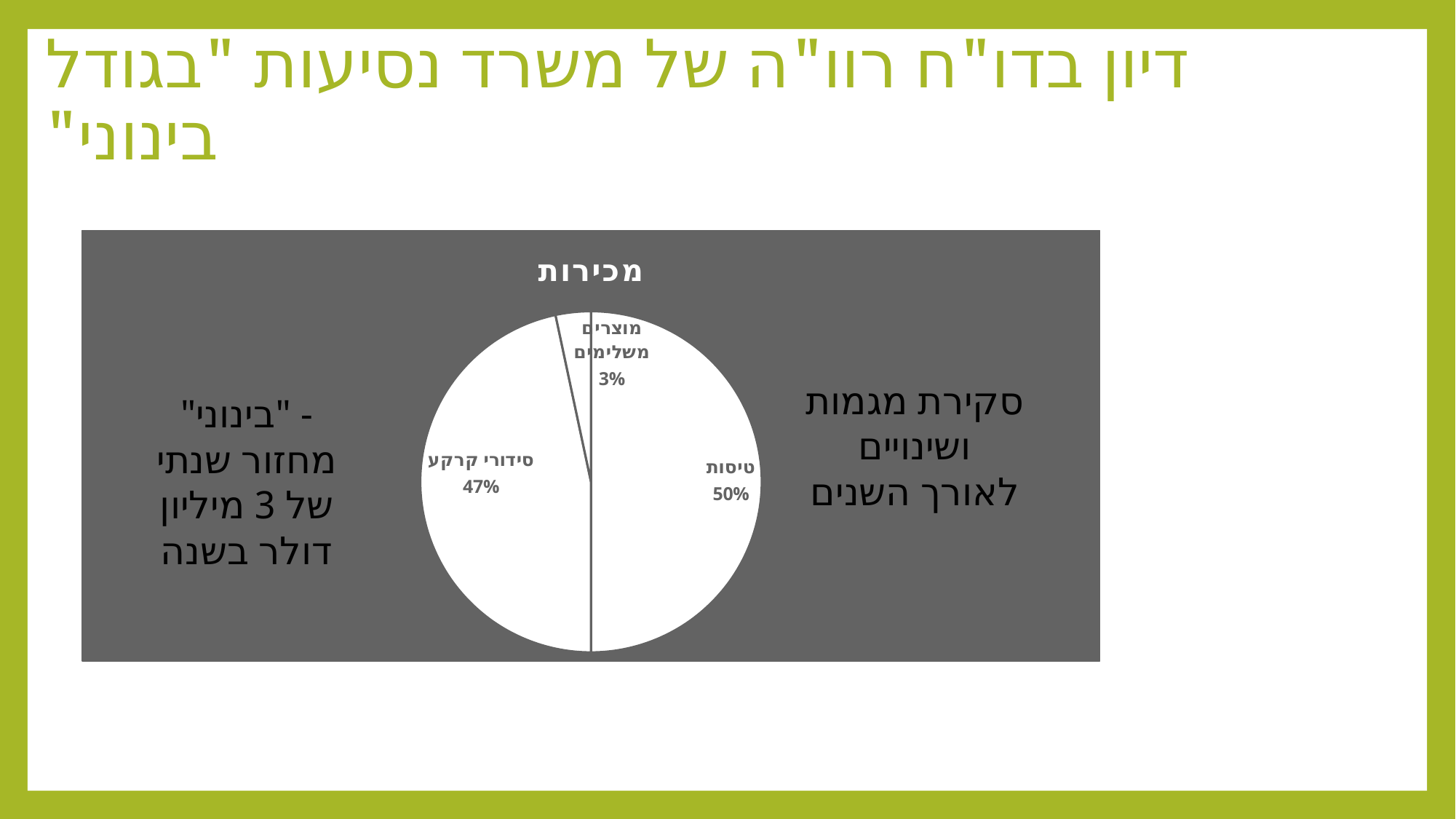
Which category has the largest slice of the pie? טיסות What share of the pie does מוצרים משלימים represent? 3% What is the difference in percentage points between סידורי קרקע and מוצרים משלימים? 44% What share of the pie does טיסות represent? 50% What type of chart is shown on the slide? pie chart What colour are the slices of the pie chart? white What share of the pie does סידורי קרקע represent? 47% What is the difference in percentage points between טיסות and סידורי קרקע? 3% Which is larger, the share for סידורי קרקע or the share for מוצרים משלימים? סידורי קרקע What is the title of the chart? מכירות Which category has the smallest slice of the pie? מוצרים משלימים How many slices does the pie chart have? 3